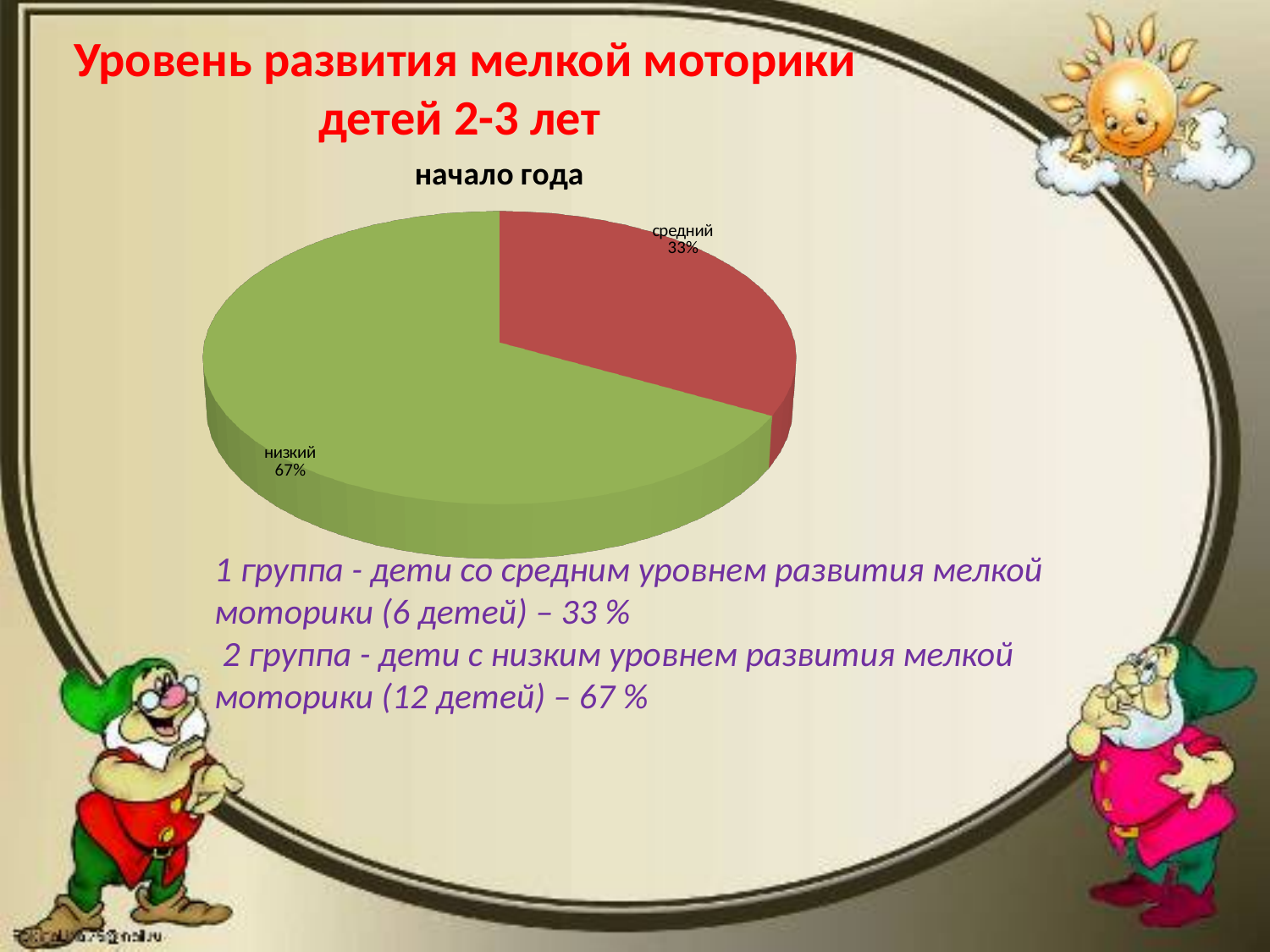
What share of the pie does the 'низкий' slice have? 67% What colour is the 'низкий' slice? green What is the title of the chart? начало года Which slice of the pie is the largest? низкий What kind of chart is shown on the slide? pie chart Which slice of the pie is the smallest? средний What is the difference in percentage points between the 'низкий' and 'средний' slices? 34 How many slices does the pie chart have? 2 What share of the pie does the 'средний' slice have? 33% Which is larger, the 'средний' slice or the 'низкий' slice? низкий